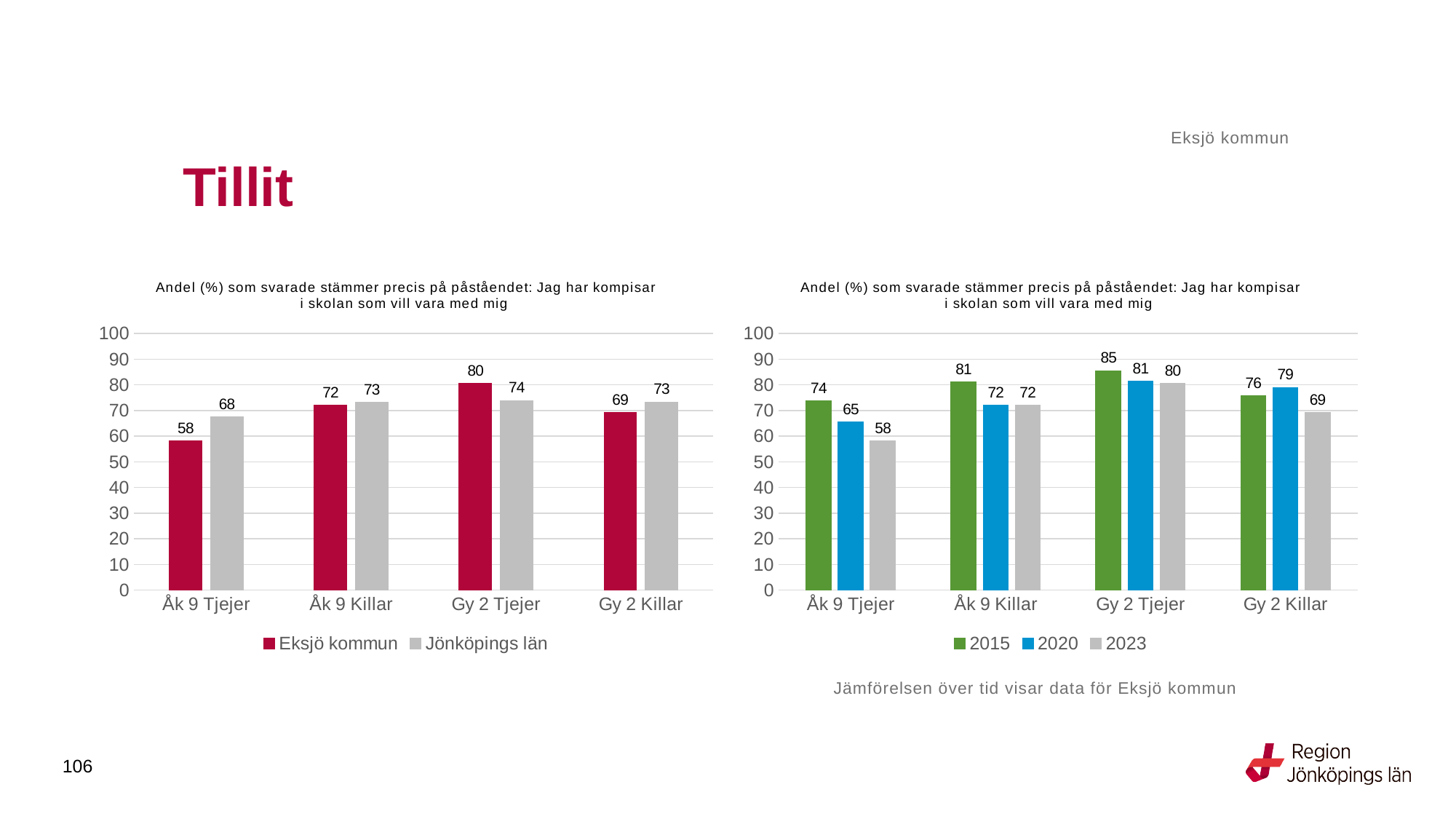
In the right chart, does the value for Åk 9 Tjejer rise or fall from 2015 to 2023? fall In the right chart, how many series does the legend list? 3 In the right chart, which category has the lowest value for 2023? Åk 9 Tjejer What kind of chart is the right chart? bar chart In the right chart, what is the value for 2015 for Gy 2 Tjejer? 85 In the left chart, which is larger for Gy 2 Killar: Eksjö kommun or Jönköpings län? Jönköpings län In the left chart, how many series does the legend list? 2 In the left chart, what is the difference between Jönköpings län and Eksjö kommun for Åk 9 Tjejer? 10 In the left chart, which category has the highest value for Eksjö kommun? Gy 2 Tjejer In the right chart, what is the value for 2023 for Gy 2 Killar? 69 In the left chart, what is the value for Jönköpings län for Gy 2 Tjejer? 74 In the left chart, what is the value for Eksjö kommun for Åk 9 Tjejer? 58